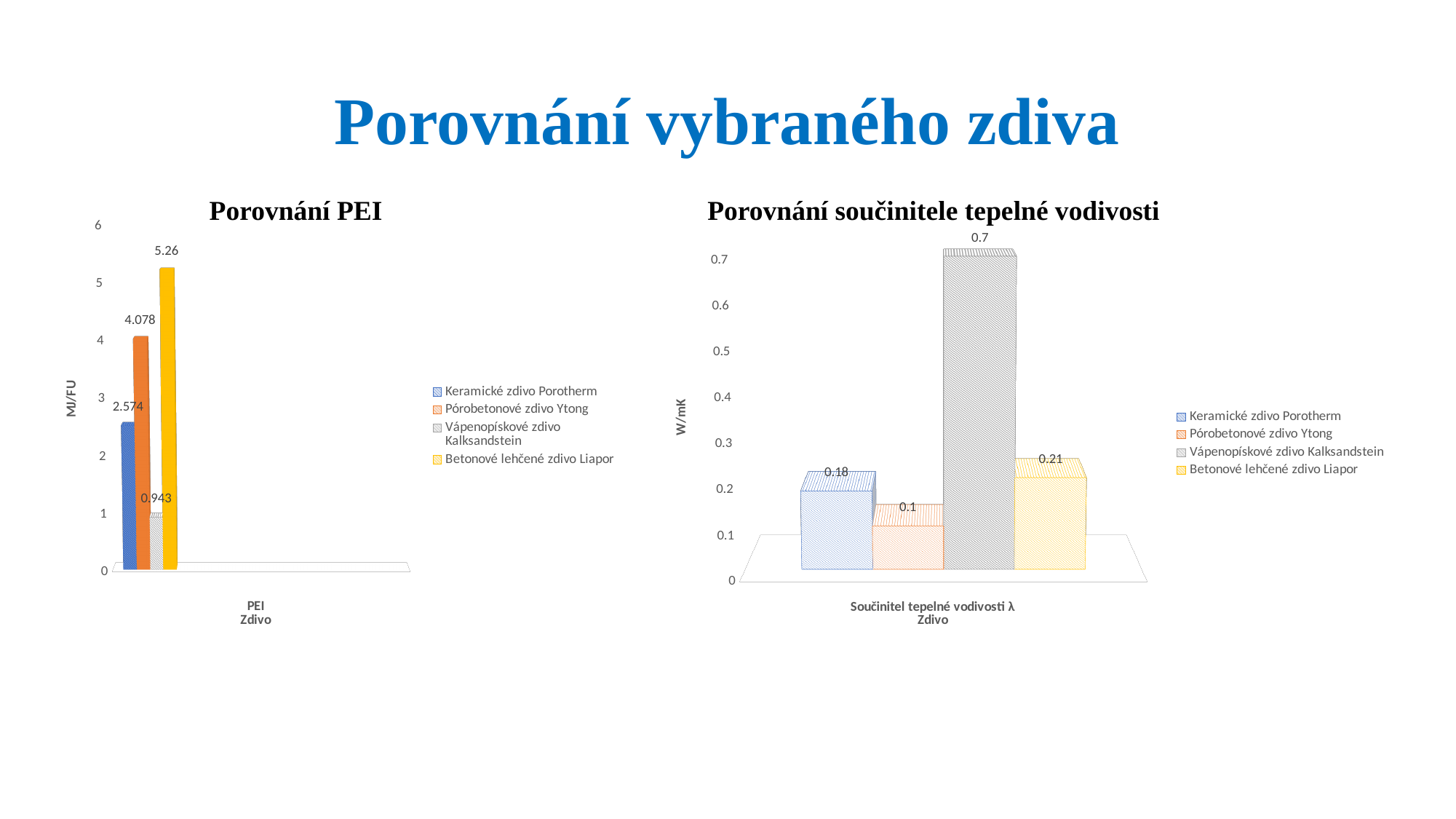
In the 'Porovnání součinitele tepelné vodivosti' chart, which series has the lowest value? Pórobetonové zdivo Ytong In the 'Porovnání PEI' chart, what is the difference between the values for Pórobetonové zdivo Ytong and Keramické zdivo Porotherm? 1.504 What type of chart is the 'Porovnání součinitele tepelné vodivosti' chart? Bar chart In the 'Porovnání PEI' chart, which series has the lowest value? Vápenopískové zdivo Kalksandstein In the 'Porovnání součinitele tepelné vodivosti' chart, what is the value for Pórobetonové zdivo Ytong? 0.1 In the 'Porovnání PEI' chart, what is the value for Betonové lehčené zdivo Liapor? 5.26 In the 'Porovnání PEI' chart, what is the value for Vápenopískové zdivo Kalksandstein? 0.943 In the 'Porovnání PEI' chart, which series has the highest value? Betonové lehčené zdivo Liapor In the 'Porovnání součinitele tepelné vodivosti' chart, what is the difference between the values for Vápenopískové zdivo Kalksandstein and Betonové lehčené zdivo Liapor? 0.49 In the 'Porovnání součinitele tepelné vodivosti' chart, which is larger: the value for Keramické zdivo Porotherm or Betonové lehčené zdivo Liapor? Betonové lehčené zdivo Liapor In the 'Porovnání součinitele tepelné vodivosti' chart, what is the value for Vápenopískové zdivo Kalksandstein? 0.7 In the 'Porovnání PEI' chart, how many series does the legend list? 4